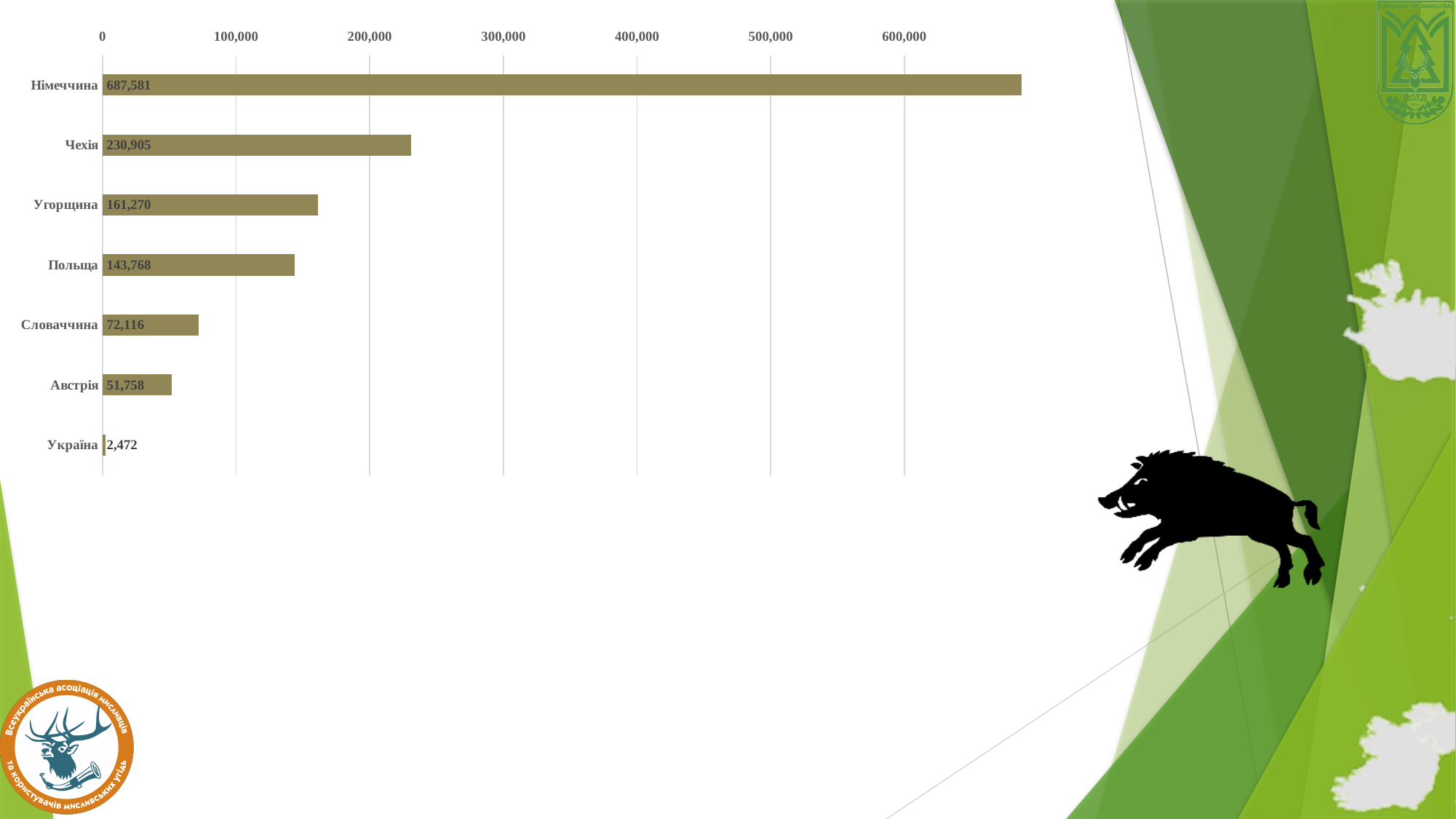
Is the value for Чехія greater or less than 200,000? greater How many categories are shown in the chart? 7 Which category has the lowest value? Україна What is the value for Україна? 2,472 What is the difference between the values for Чехія and Угорщина? 69,635 What is the value for Польща? 143,768 Which is larger, the value for Угорщина or the value for Польща? Угорщина Which category has the highest value? Німеччина What is the difference between the values for Словаччина and Австрія? 20,358 What is the value for Словаччина? 72,116 What is the value for Німеччина? 687,581 What kind of chart is shown on the slide? bar chart